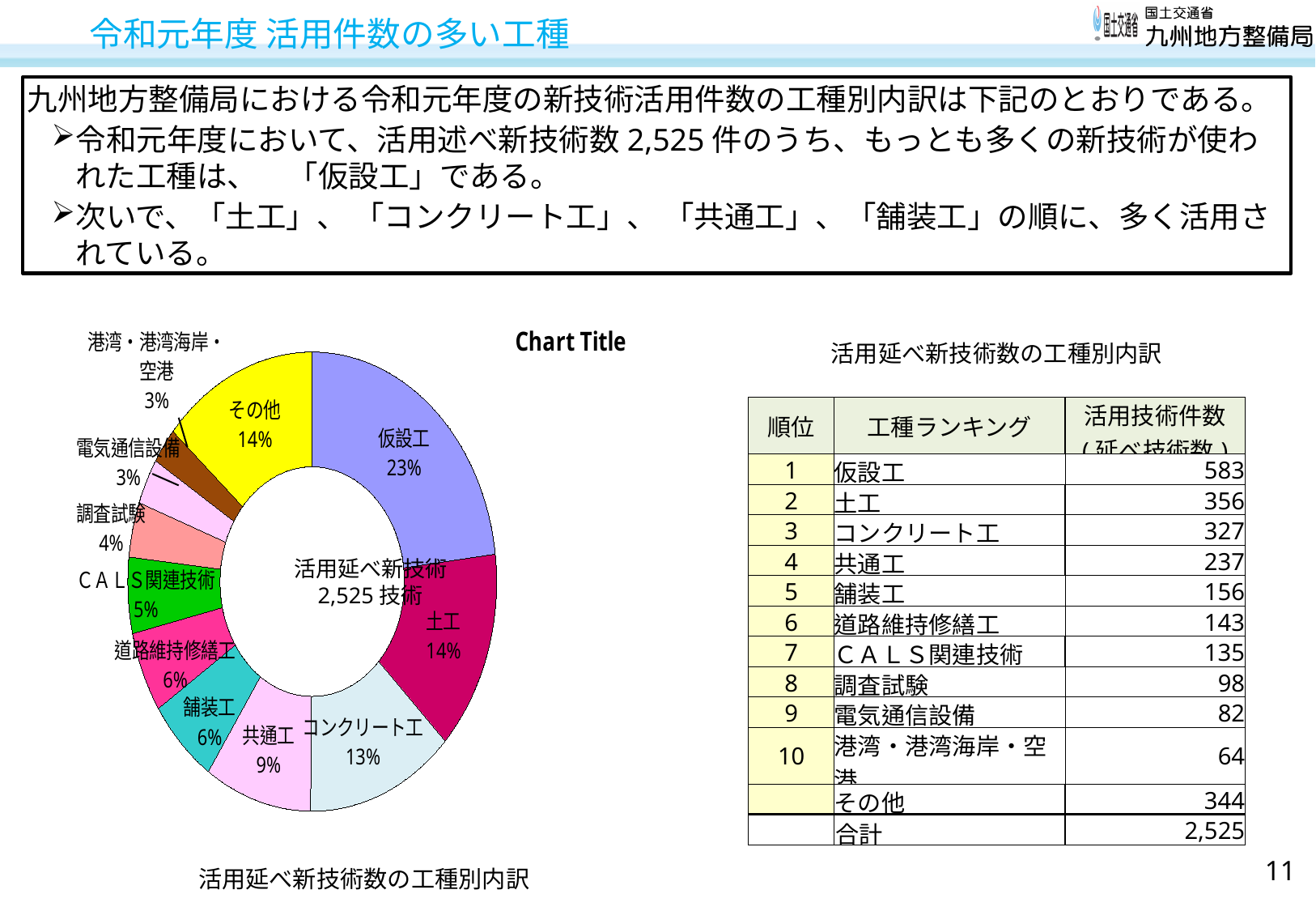
What percentage share does 共通工 have in the doughnut chart? 9% What total number of technologies is shown in the centre of the doughnut chart? 2,525 技術 What percentage share does 仮設工 have in the doughnut chart? 23% What is the difference in percentage points between 仮設工 and 土工 in the doughnut chart? 9 What percentage share does 調査試験 have in the doughnut chart? 4% What percentage share does CALS関連技術 have in the doughnut chart? 5% Which category has the largest slice in the doughnut chart? 仮設工 What kind of chart is shown on the slide? Doughnut (pie) chart Which slice is larger in the doughnut chart, 共通工 or 舗装工? 共通工 How many slices does the doughnut chart have? 11 What is the title printed above the doughnut chart? Chart Title What percentage share does コンクリート工 have in the doughnut chart? 13%